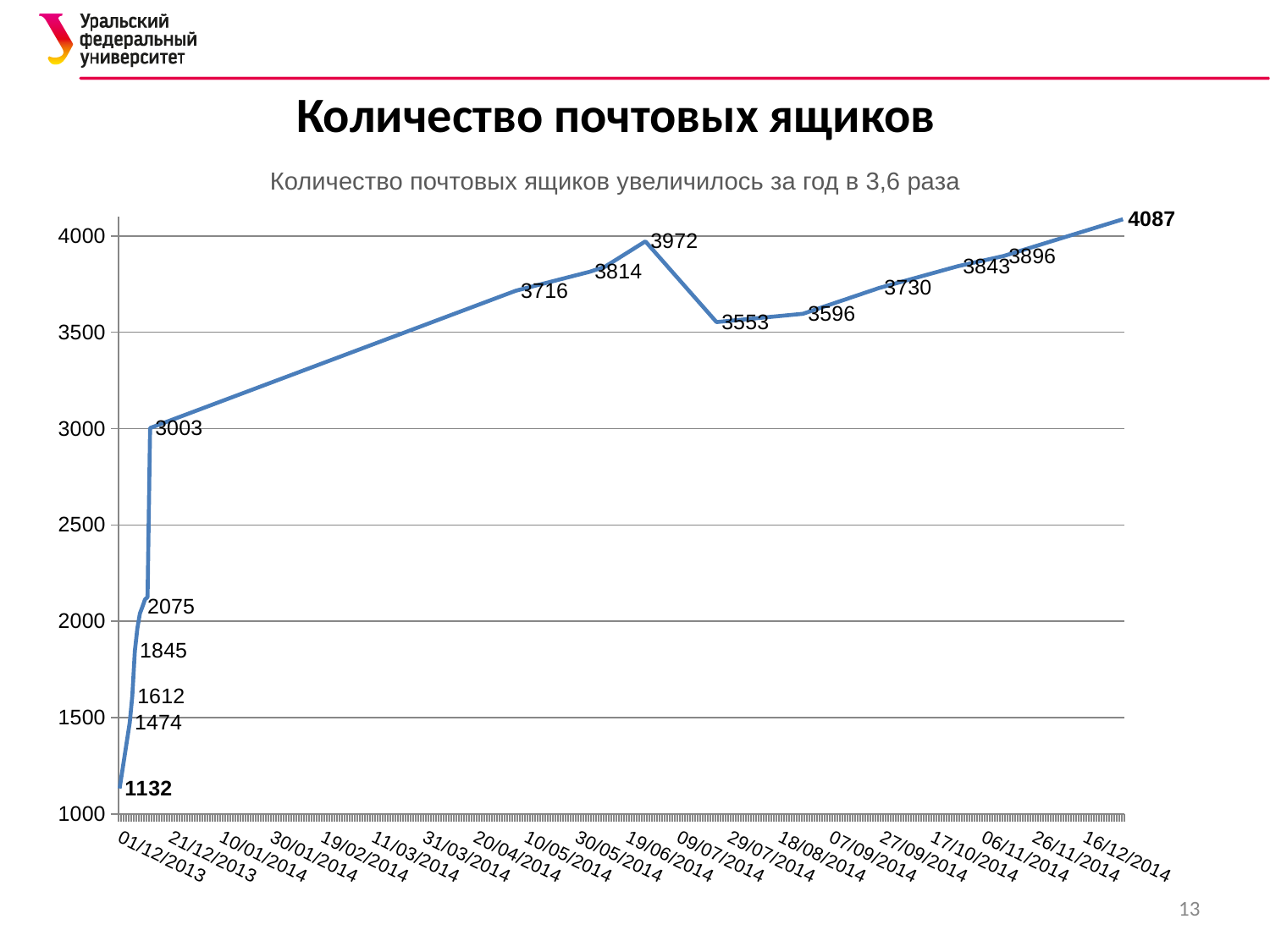
What is the value of the first data point on the line? 1132 What is the difference between the last labeled value (4087) and the first labeled value (1132)? 2955 How many data points are labeled with values on the line? 15 Overall, do the values rise or fall from the left of the x axis to the right? rise What kind of chart is shown on the slide? line chart By how much does the value drop from the peak of 3972 to the next point of 3553? 419 What is the highest value labeled on the line? 4087 What is the value of the last data point on the line? 4087 Which is larger, the point labeled 3814 or the point labeled 3896? 3896 What is the lowest value labeled on the line? 1132 What is the value of the data point immediately after the peak of 3972? 3553 What is the subtitle shown above the chart? Количество почтовых ящиков увеличилось за год в 3,6 раза